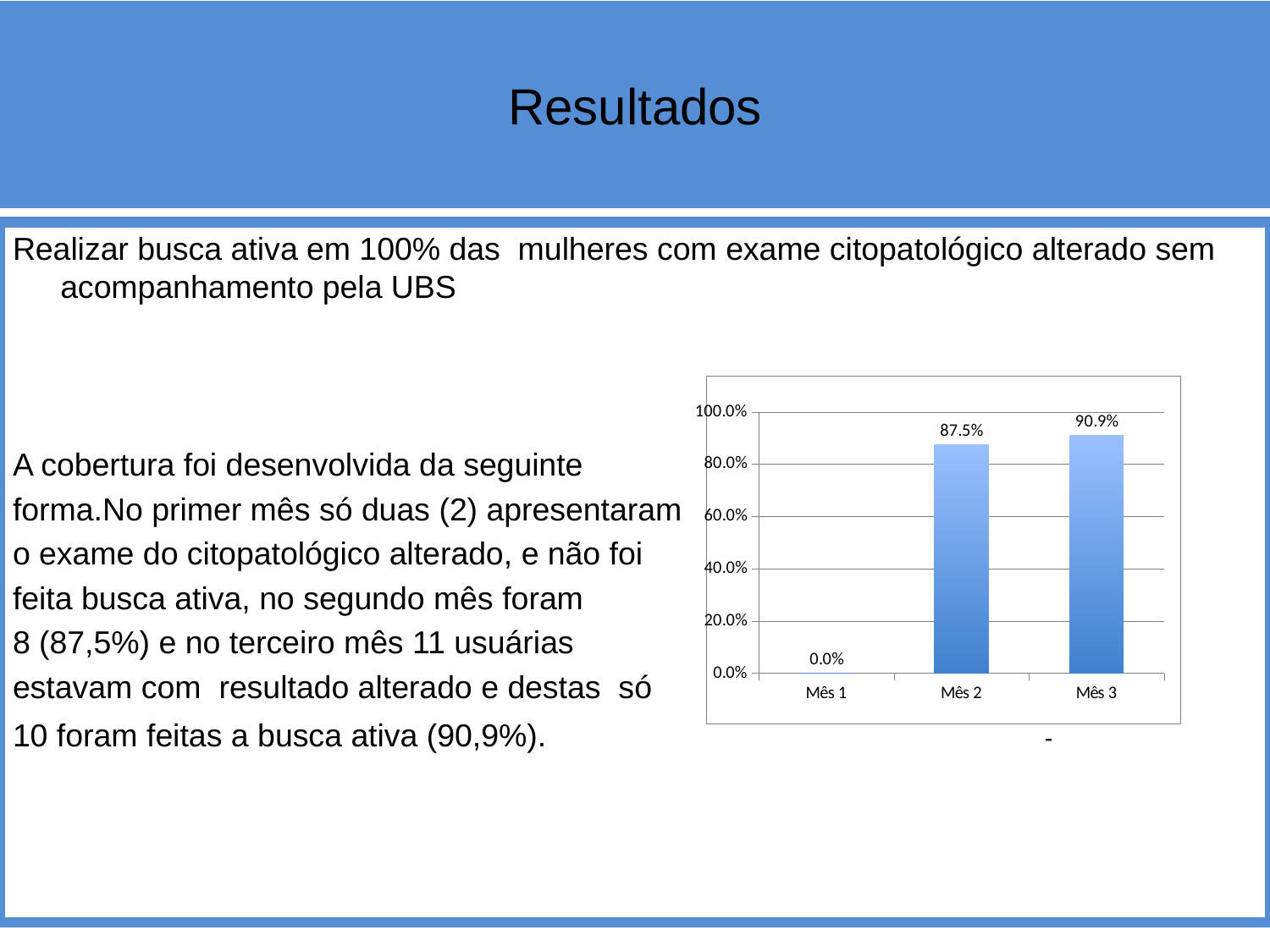
What is the value for Mês 3? 90.9% What is the difference between the values for Mês 3 and Mês 2? 3.4% Is the value for Mês 2 greater or less than 80.0%? greater Which is larger, the value for Mês 2 or the value for Mês 3? Mês 3 What kind of chart is shown on the slide? bar chart Which month has the highest value? Mês 3 Do the values rise or fall from Mês 1 to Mês 3? rise What is the value for Mês 1? 0.0% What is the highest tick label on the vertical axis? 100.0% What is the value for Mês 2? 87.5% How many categories are shown on the x axis? 3 Which month has the lowest value? Mês 1